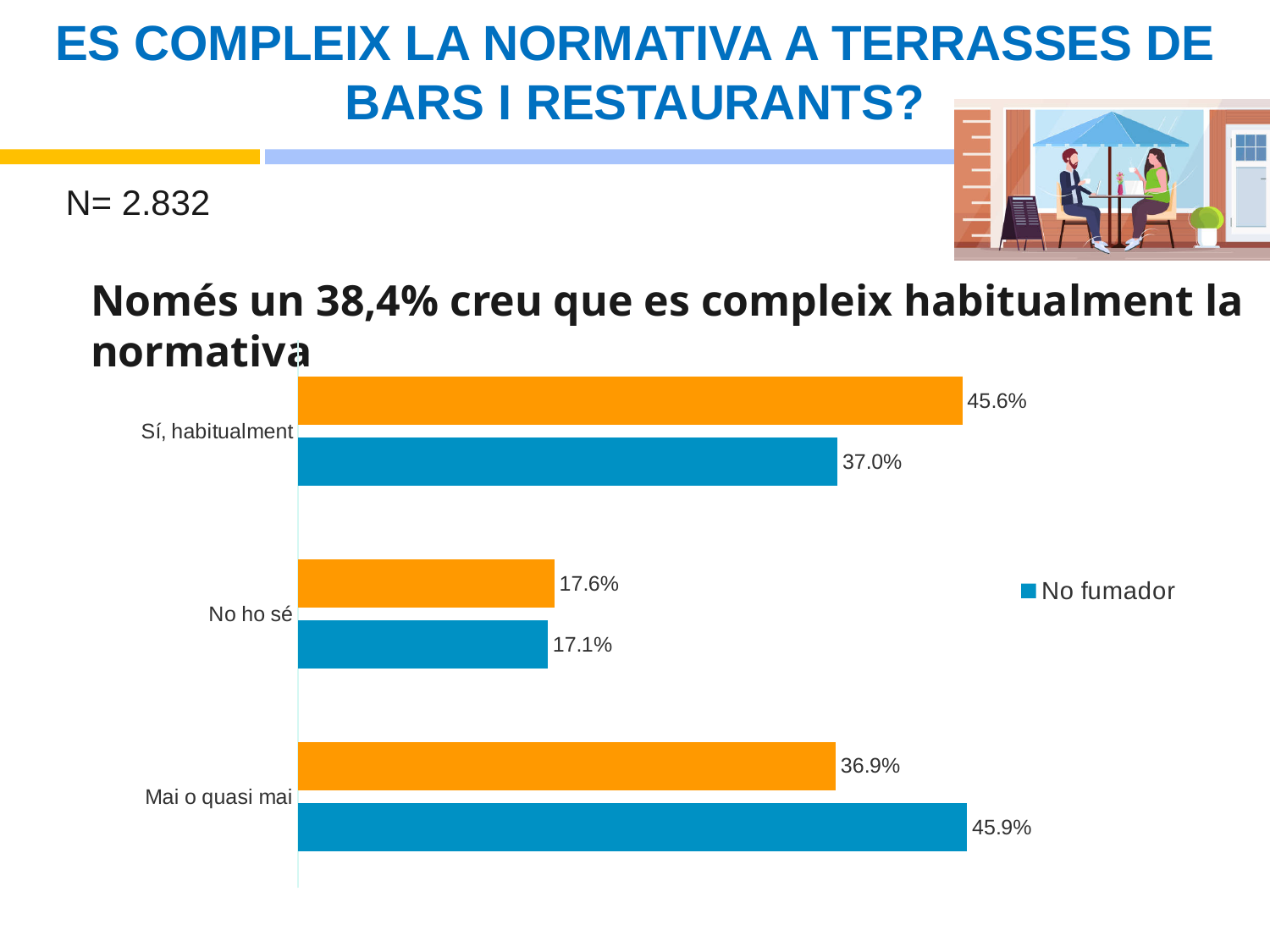
What series name is shown in the chart legend? No fumador How many categories are shown on the chart? 3 For "No ho sé", which bar is larger, the orange bar or the No fumador bar? The orange bar For "Sí, habitualment", how much higher is the orange bar than the No fumador bar? 8.6 percentage points For "Mai o quasi mai", how much higher is the No fumador bar than the orange bar? 9.0 percentage points What is the value of the No fumador bar for "Sí, habitualment"? 37.0% What kind of chart is shown on the slide? Bar chart What is the value of the No fumador bar for "No ho sé"? 17.1% For the orange series, which category has the lowest value? No ho sé What is the value of the orange bar for "Sí, habitualment"? 45.6% For the No fumador series, which category has the highest value? Mai o quasi mai What is the value of the orange bar for "Mai o quasi mai"? 36.9%